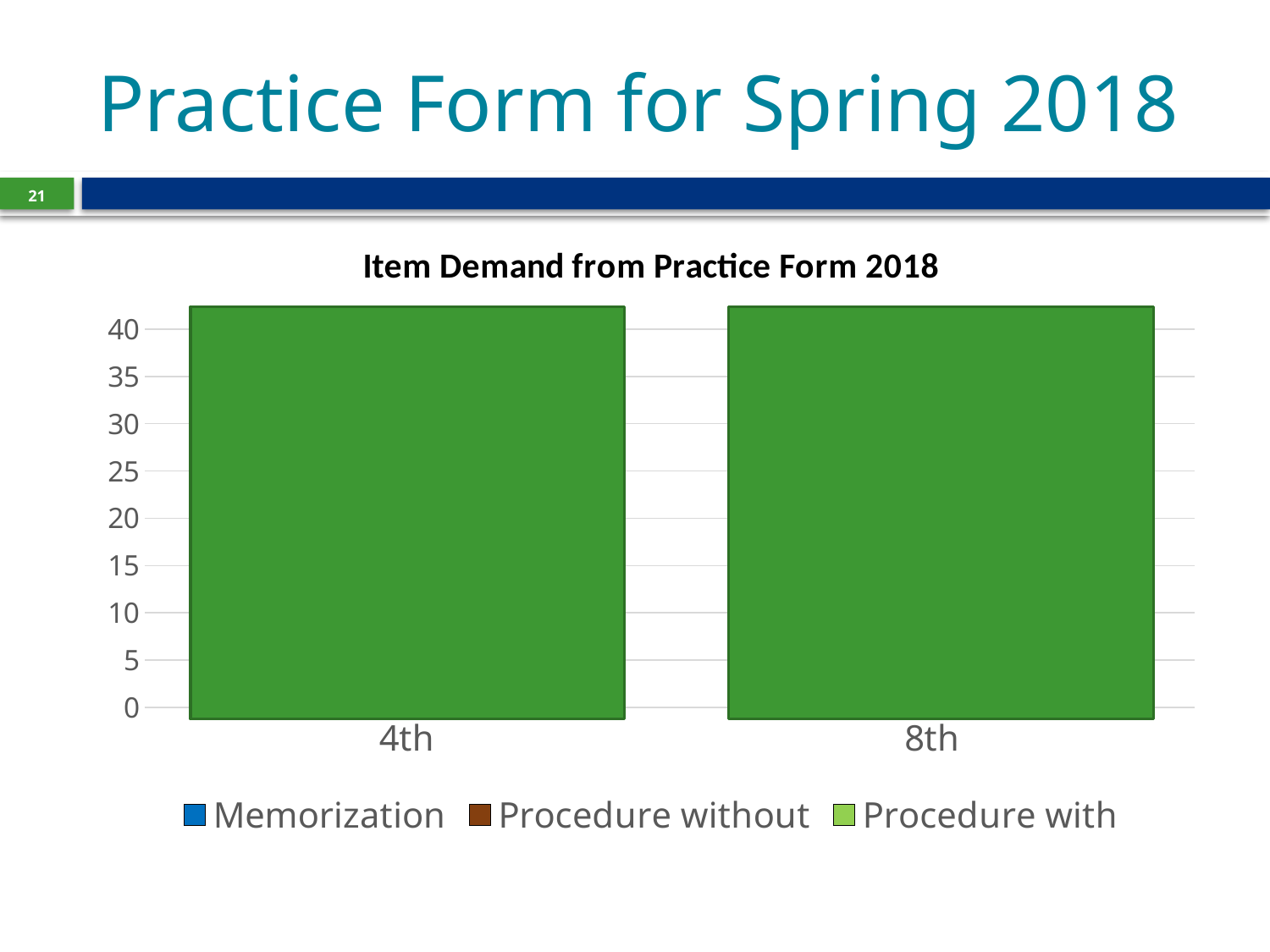
How many categories are shown on the x axis of the chart? 2 How many series does the chart's legend list? 3 Is the value of the bar for 8th greater or less than 40? greater What are the two category labels on the x axis of the chart? 4th and 8th What kind of chart is shown on the slide? bar chart Which series in the legend is shown in green? Procedure with Is the value of the bar for 4th greater or less than 35? greater Is the value of the bar for 4th greater or less than 40? greater What is the title of the chart? Item Demand from Practice Form 2018